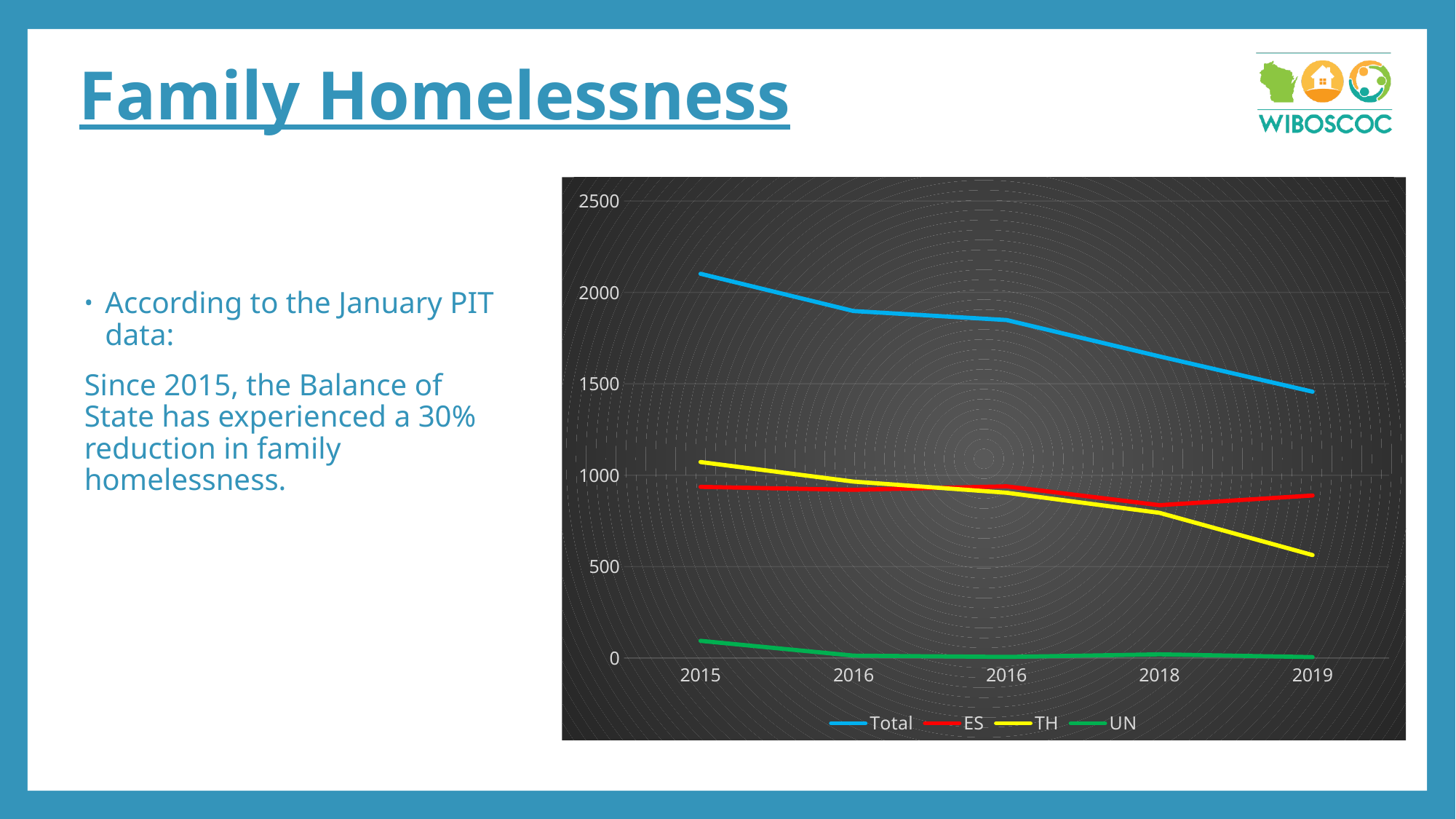
Does the Total series rise or fall from 2015 to 2019? fall Is the value for Total in 2018 greater or less than 1500? greater Is the value for TH in 2019 greater or less than 1000? less How many points are plotted along the x axis for each series? 5 What kind of chart is shown on the slide? line chart Is the value for Total in 2015 greater or less than 2000? greater Does the TH series rise or fall from 2015 to 2019? fall What colour is the line for the Total series? blue In 2019, which series has the larger value, ES or TH? ES Which series has the lowest values across all years? UN How many series does the chart legend list? 4